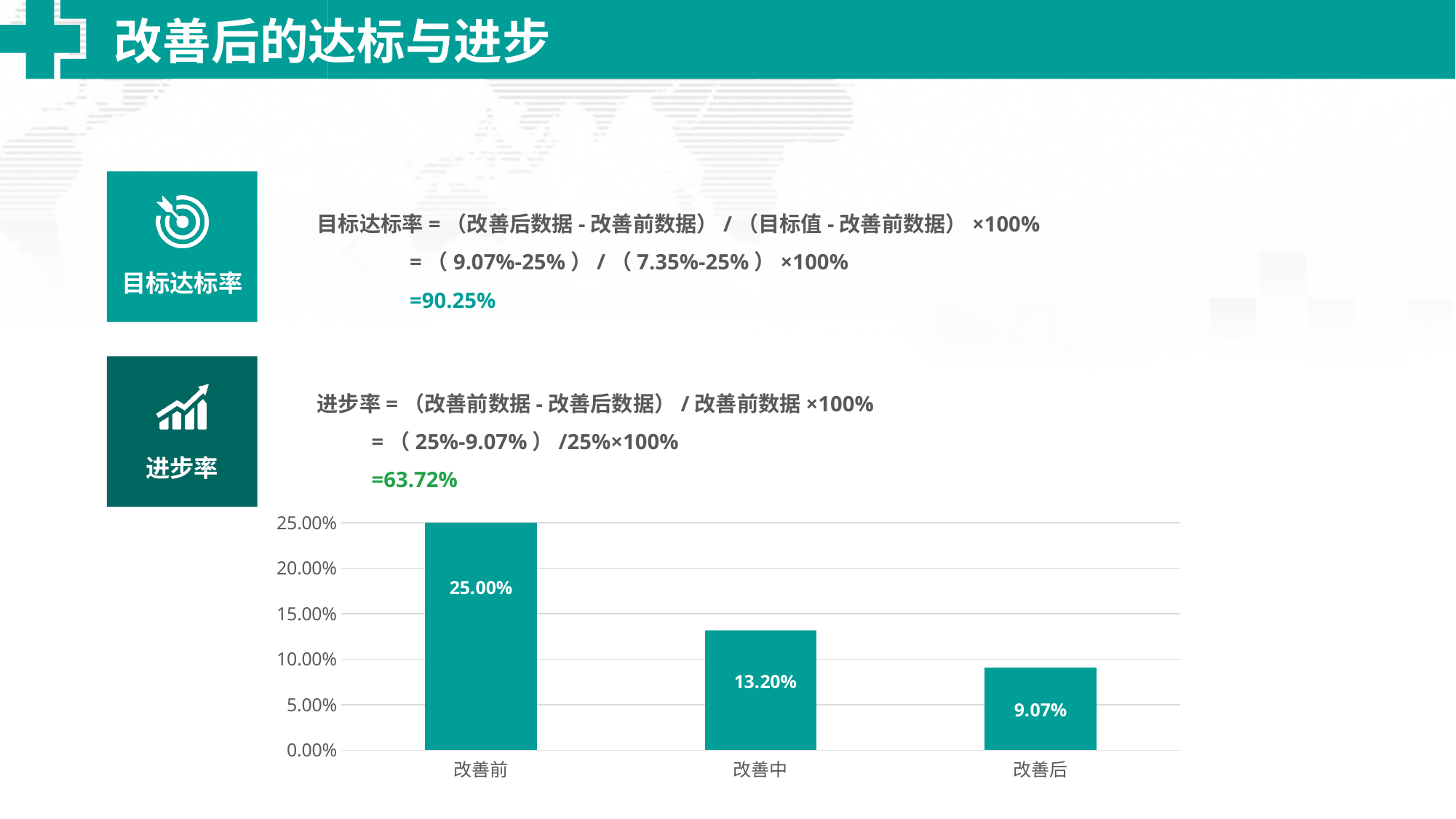
Which is larger, the value for 改善中 or the value for 改善后? 改善中 How many categories are shown on the x axis? 3 What is the value for 改善中? 13.20% Is the value for 改善中 greater or less than 10.00%? greater Which category has the lowest value? 改善后 What is the value for 改善后? 9.07% What is the difference between the values for 改善前 and 改善后? 15.93% What is the value for 改善前? 25.00% What kind of chart is shown on the slide? bar chart Which category has the highest value? 改善前 What is the difference between the values for 改善中 and 改善后? 4.13% Do the values rise or fall from 改善前 to 改善后? fall